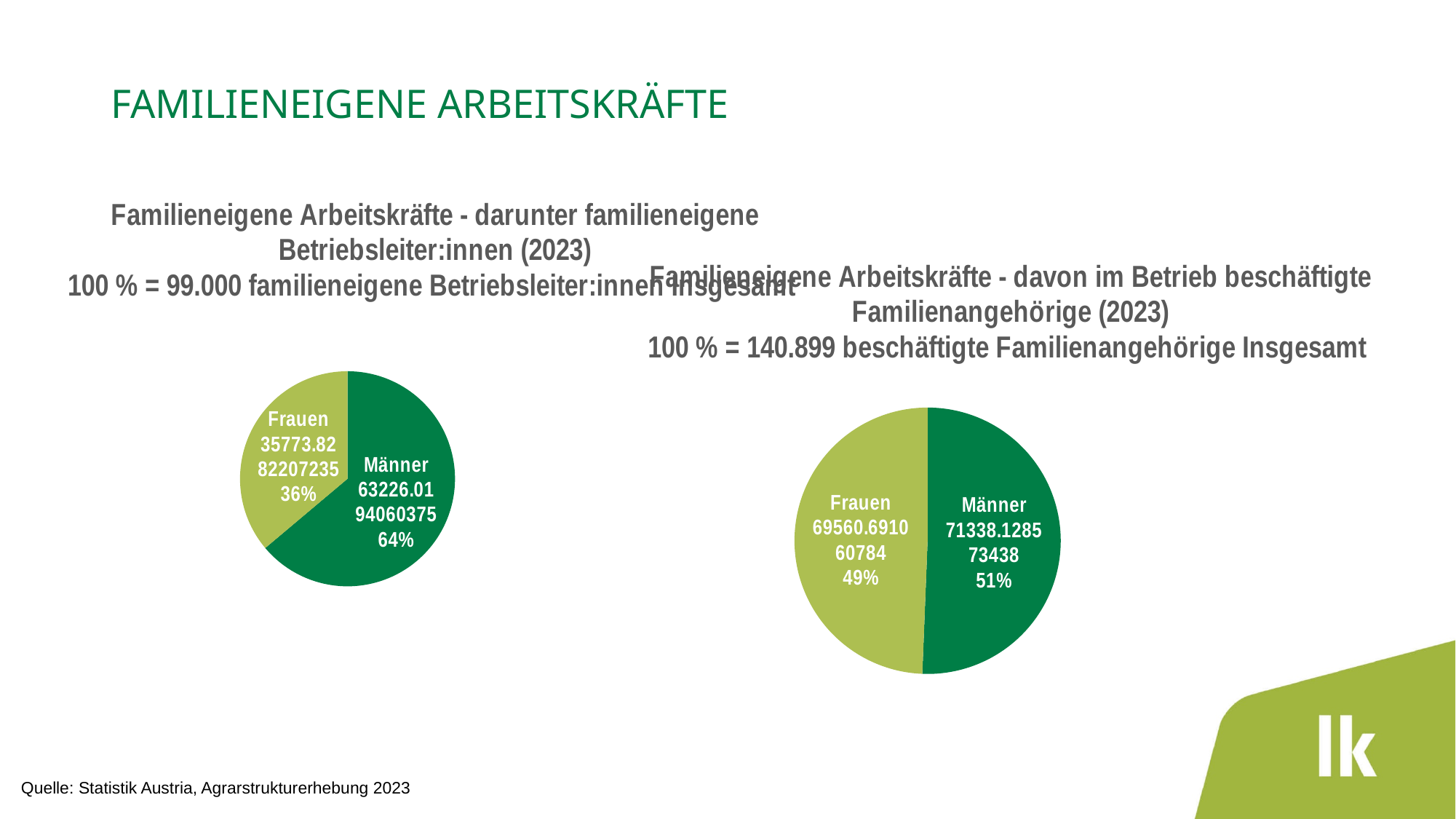
In the right pie chart (im Betrieb beschäftigte Familienangehörige), what share do Männer hold? 51% In the left pie chart (familieneigene Betriebsleiter:innen), which slice is larger, Frauen or Männer? Männer In the left pie chart (familieneigene Betriebsleiter:innen), what is the difference in percentage points between the Männer and Frauen shares? 28 percentage points According to the subtitle of the right chart, how many beschäftigte Familienangehörige correspond to 100 %? 140.899 In the left pie chart (familieneigene Betriebsleiter:innen), what share do Männer hold? 64% How many slices does the right pie chart (im Betrieb beschäftigte Familienangehörige) have? 2 In the right pie chart (im Betrieb beschäftigte Familienangehörige), what share do Frauen hold? 49% How many slices does the left pie chart (familieneigene Betriebsleiter:innen) have? 2 In the right pie chart (im Betrieb beschäftigte Familienangehörige), what is the difference in percentage points between the Männer and Frauen shares? 2 percentage points According to the subtitle of the left chart, how many familieneigene Betriebsleiter:innen correspond to 100 %? 99.000 What type of chart is used for the right chart (im Betrieb beschäftigte Familienangehörige)? Pie chart